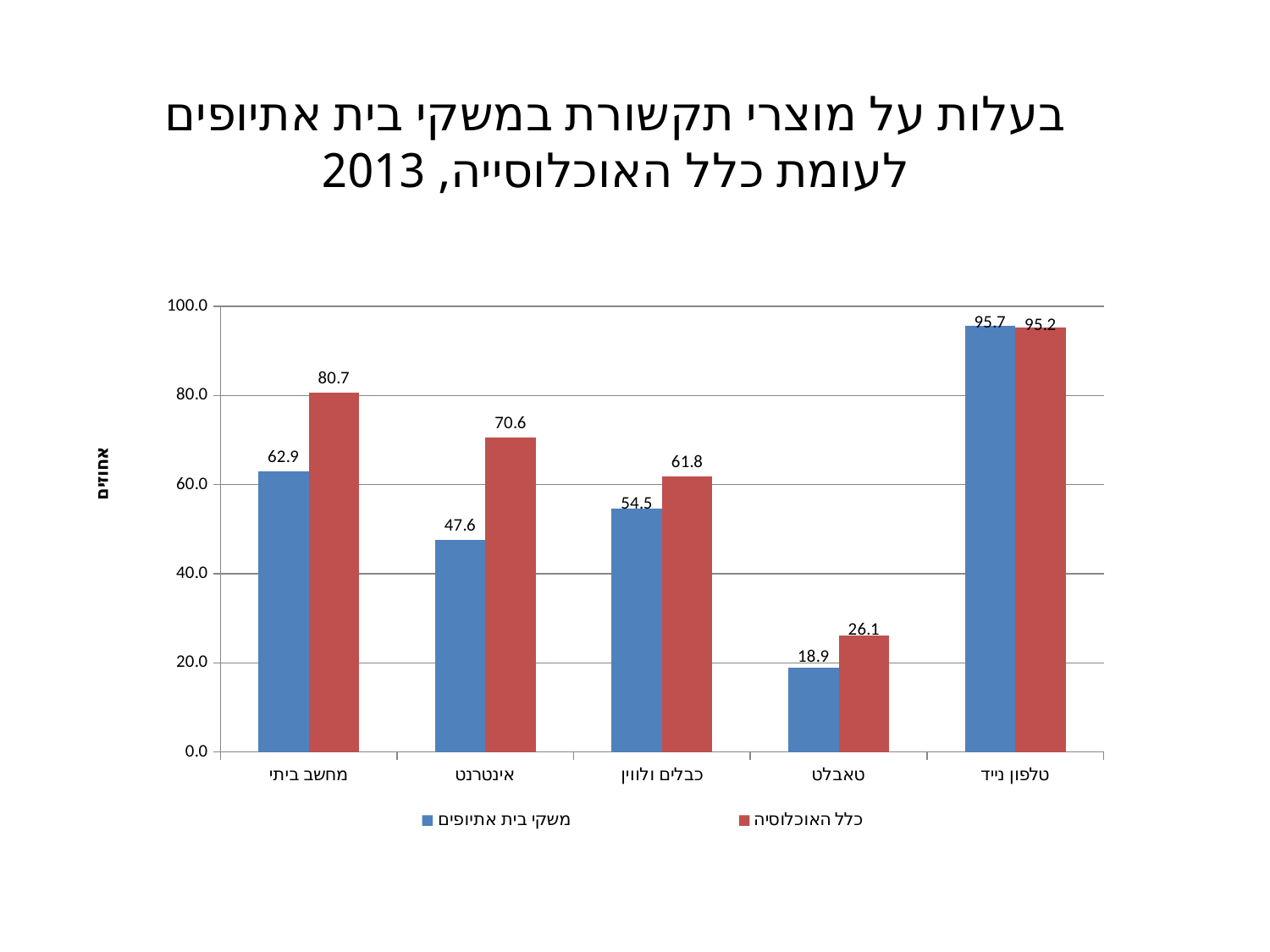
Which category has the lowest value for כלל האוכלוסיה? טאבלט What kind of chart is shown on the slide? bar chart What is the value for משקי בית אתיופים in the טאבלט category? 18.9 What is the label of the y axis? אחוזים What is the value for משקי בית אתיופים in the מחשב ביתי category? 62.9 Which category has the highest value for משקי בית אתיופים? טלפון נייד What is the difference between כלל האוכלוסיה and משקי בית אתיופים in the אינטרנט category? 23.0 In the מחשב ביתי category, which series has the larger value, משקי בית אתיופים or כלל האוכלוסיה? כלל האוכלוסיה How many series does the legend list? 2 What is the value for כלל האוכלוסיה in the כבלים ולווין category? 61.8 What is the value for כלל האוכלוסיה in the אינטרנט category? 70.6 How many categories are shown on the x axis? 5